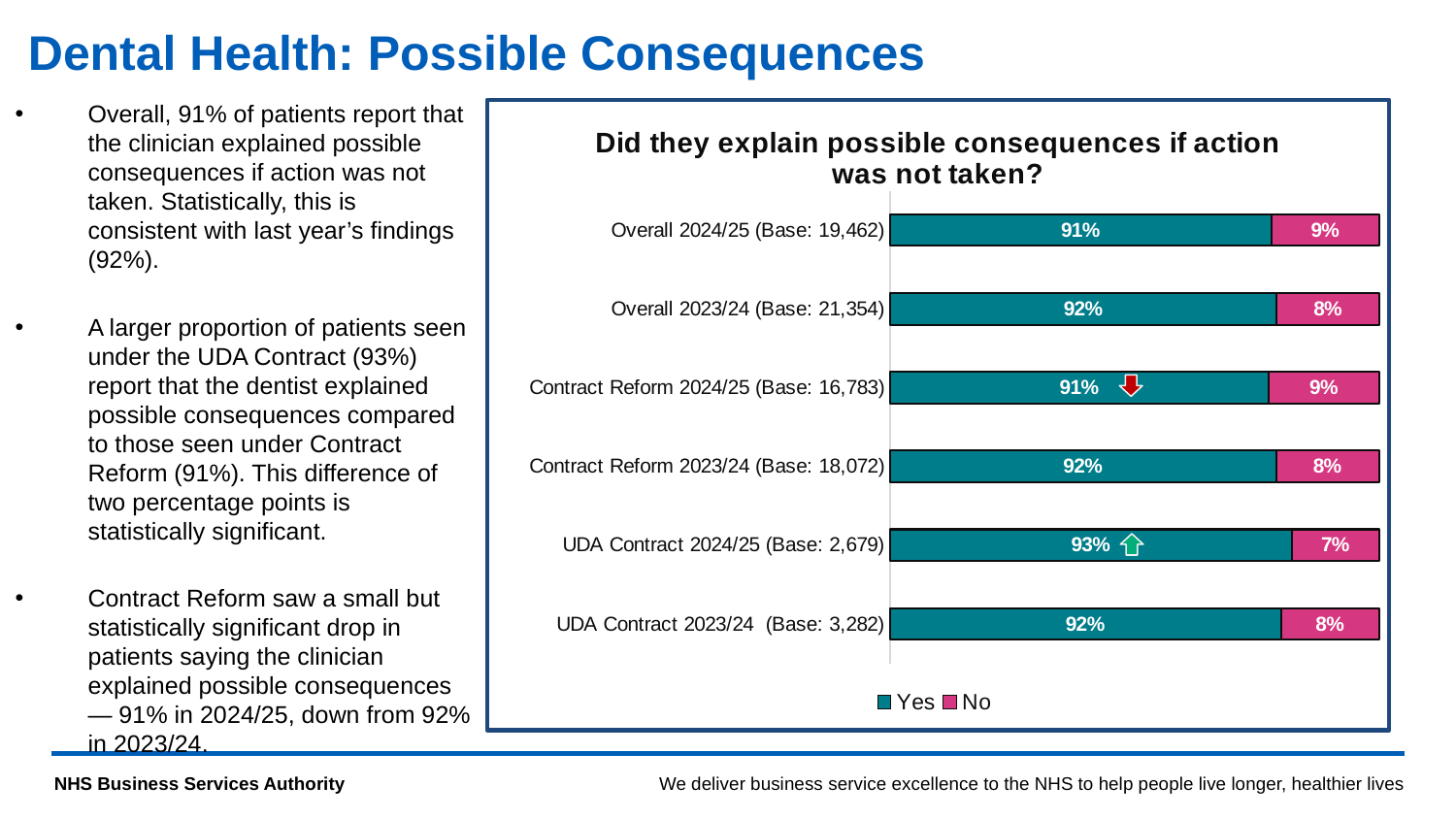
Which category has the lowest No percentage? UDA Contract 2024/25 What type of chart is shown? Stacked bar chart Which category has the highest Yes percentage? UDA Contract 2024/25 What is the difference in Yes percentage between UDA Contract 2024/25 and Contract Reform 2024/25? 2 percentage points How many categories (bars) are shown in the chart? 6 How many series does the legend list? 2 Which is larger, the Yes value for Overall 2023/24 or the Yes value for Overall 2024/25? Overall 2023/24 What is the Yes value for Contract Reform 2023/24? 92% What is the total of the Yes and No values for Contract Reform 2024/25? 100% What is the base (number of respondents) for UDA Contract 2023/24? 3,282 What is the No value for UDA Contract 2024/25? 7% What percentage of Overall 2024/25 respondents answered Yes? 91%